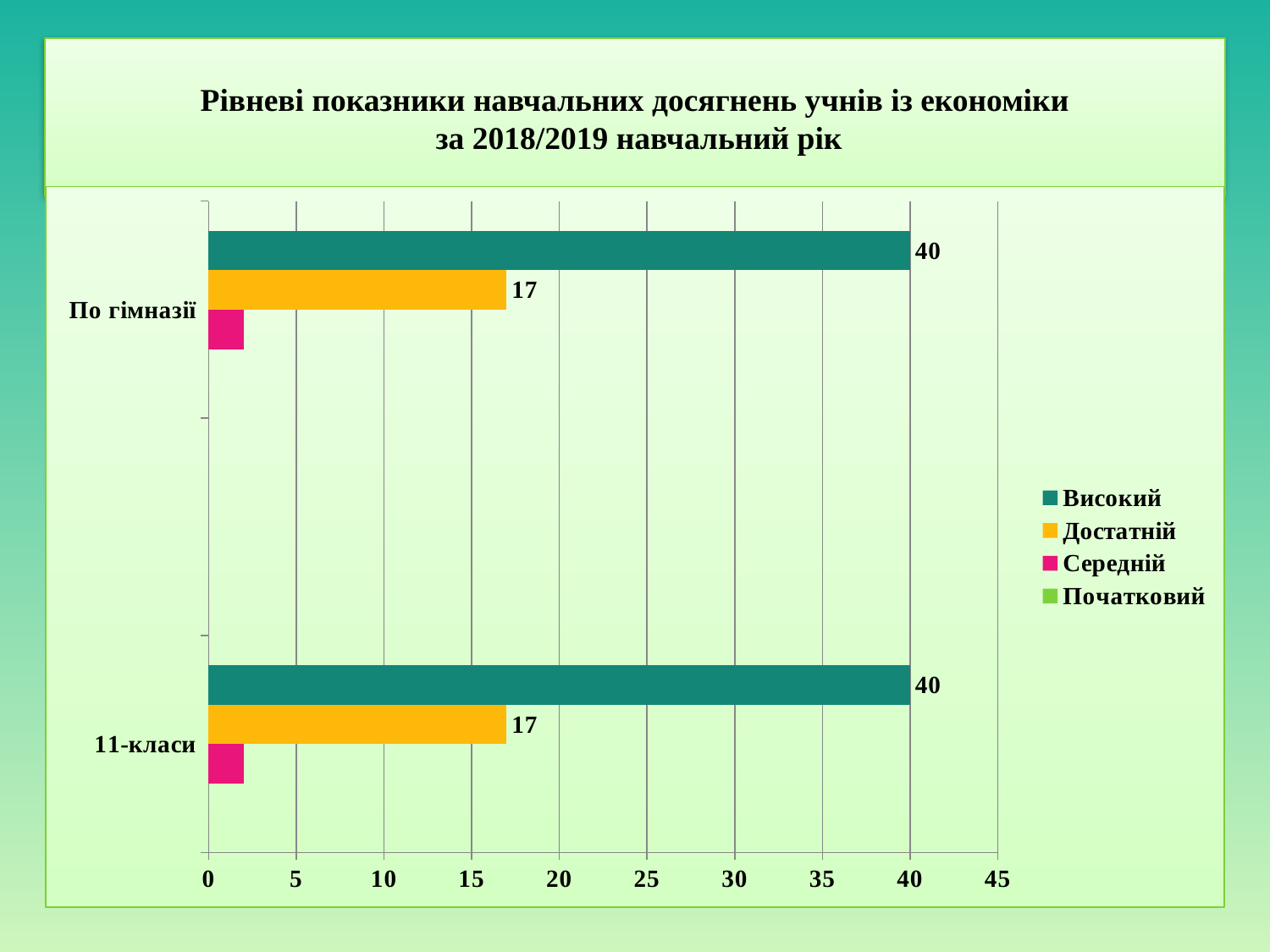
What is the value for Достатній in the 11-класи category? 17 What is the value for Високий in the 11-класи category? 40 Is the value for Середній in the По гімназії category greater or less than 5? less Is the value for Достатній in the 11-класи category greater or less than 20? less What is the difference between the Високий and Достатній values for По гімназії? 23 How many categories are shown on the vertical axis? 2 Which series has the longest bar in the По гімназії category? Високий What kind of chart is shown on the slide? Bar chart What is the highest value shown on the horizontal axis? 45 Which is larger for 11-класи: Високий or Достатній? Високий What is the value for Високий in the По гімназії category? 40 How many series does the legend list? 4